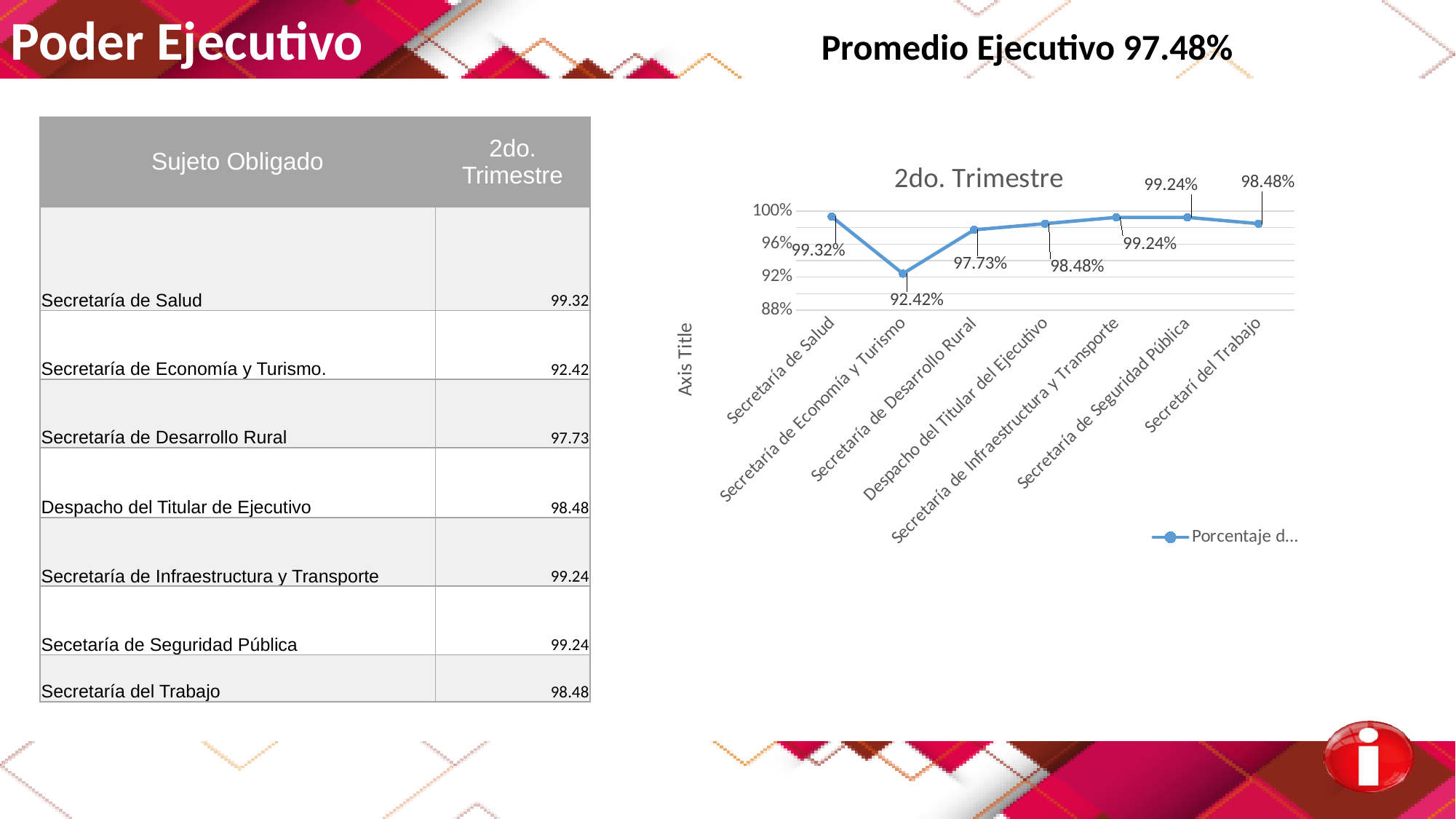
What is the difference between the values for Secretaría de Salud and Secretaría de Economía y Turismo? 6.90% Which category has the lowest value in the chart? Secretaría de Economía y Turismo What is the value for Secretaría de Economía y Turismo in the chart? 92.42% What is the chart's title? 2do. Trimestre What is the value for Secretaría de Salud in the chart? 99.32% Which category has the highest value in the chart? Secretaría de Salud Which is larger, the value for Secretaría de Desarrollo Rural or the value for Secretaría de Infraestructura y Transporte? Secretaría de Infraestructura y Transporte How many categories are plotted on the x axis of the chart? 7 What type of chart is shown on the slide? line chart What is the value for Despacho del Titular del Ejecutivo in the chart? 98.48% Is the value for Secretaría de Economía y Turismo greater or less than 96%? less What is the value for Secretaría de Desarrollo Rural in the chart? 97.73%